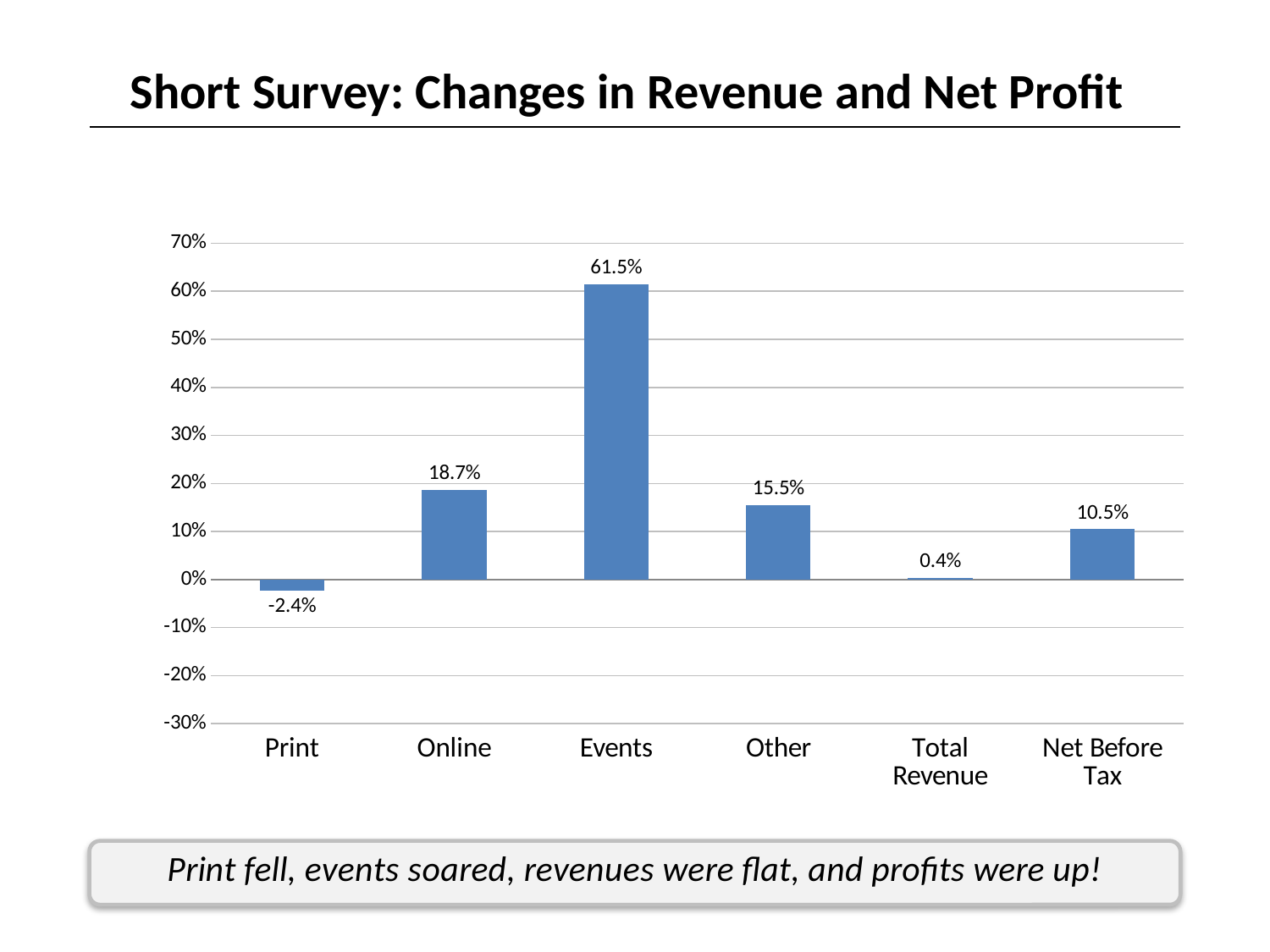
How many categories are shown on the x axis? 6 Is the value for Events greater or less than 50%? greater What is the value for Net Before Tax? 10.5% What is the title of the slide? Short Survey: Changes in Revenue and Net Profit What is the value for Total Revenue? 0.4% Which category has the highest value? Events Which is larger, the value for Online or the value for Net Before Tax? Online What is the value for Print? -2.4% Which category has the lowest value? Print What kind of chart is shown on the slide? Bar chart What is the value for Events? 61.5% What is the difference between the values for Online and Other? 3.2%